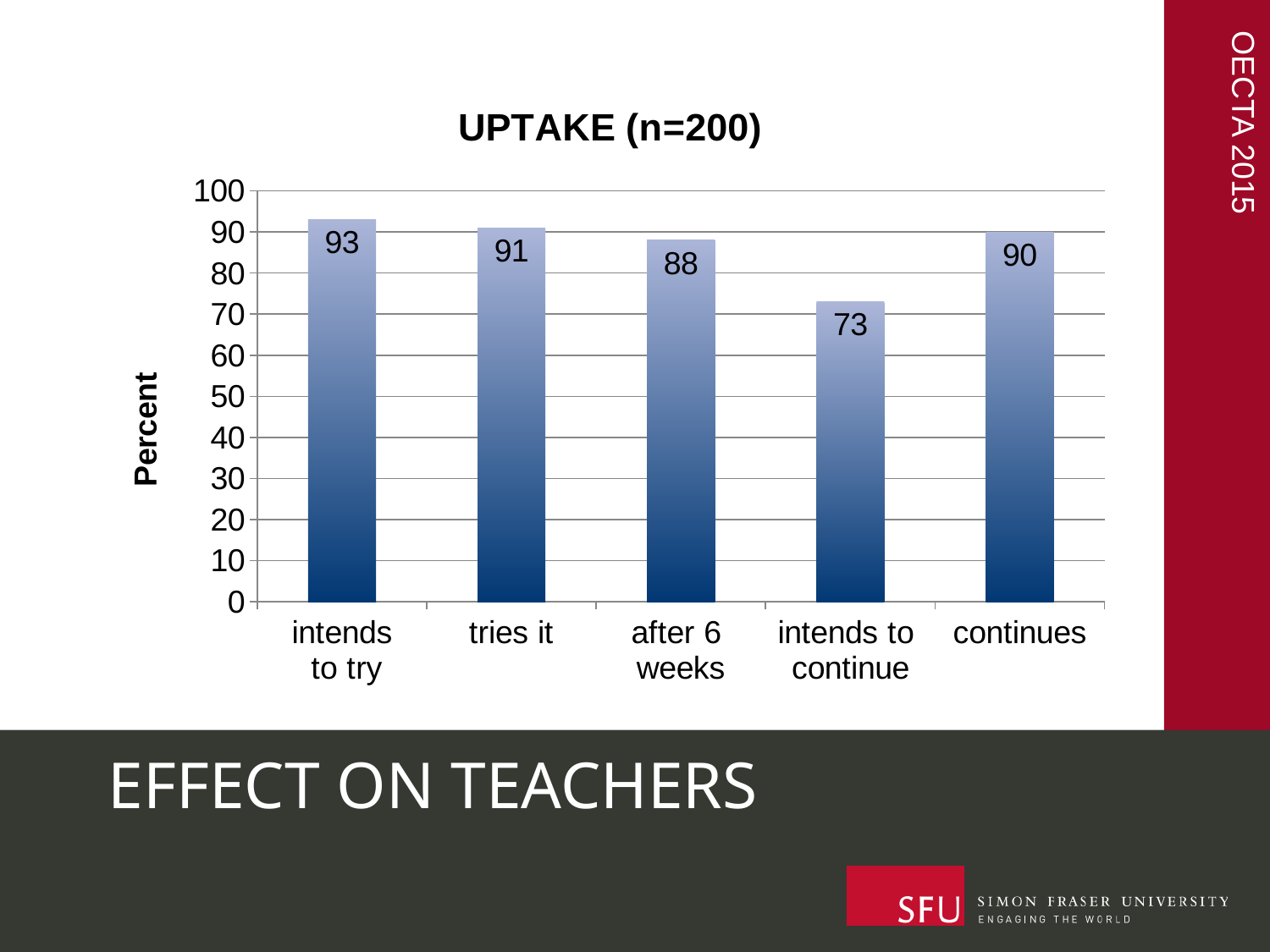
What is the value for "intends to continue"? 73 Is the value for "intends to continue" greater or less than 80? less What is the title of the chart? UPTAKE (n=200) What is the value for "after 6 weeks"? 88 Which is larger, the value for "after 6 weeks" or the value for "intends to continue"? after 6 weeks What is the difference between the values for "tries it" and "continues"? 1 What is the value for "intends to try"? 93 What is the difference between the values for "intends to try" and "intends to continue"? 20 What kind of chart is shown on the slide? bar chart How many categories are shown on the x axis? 5 Which category has the highest value? intends to try Which category has the lowest value? intends to continue